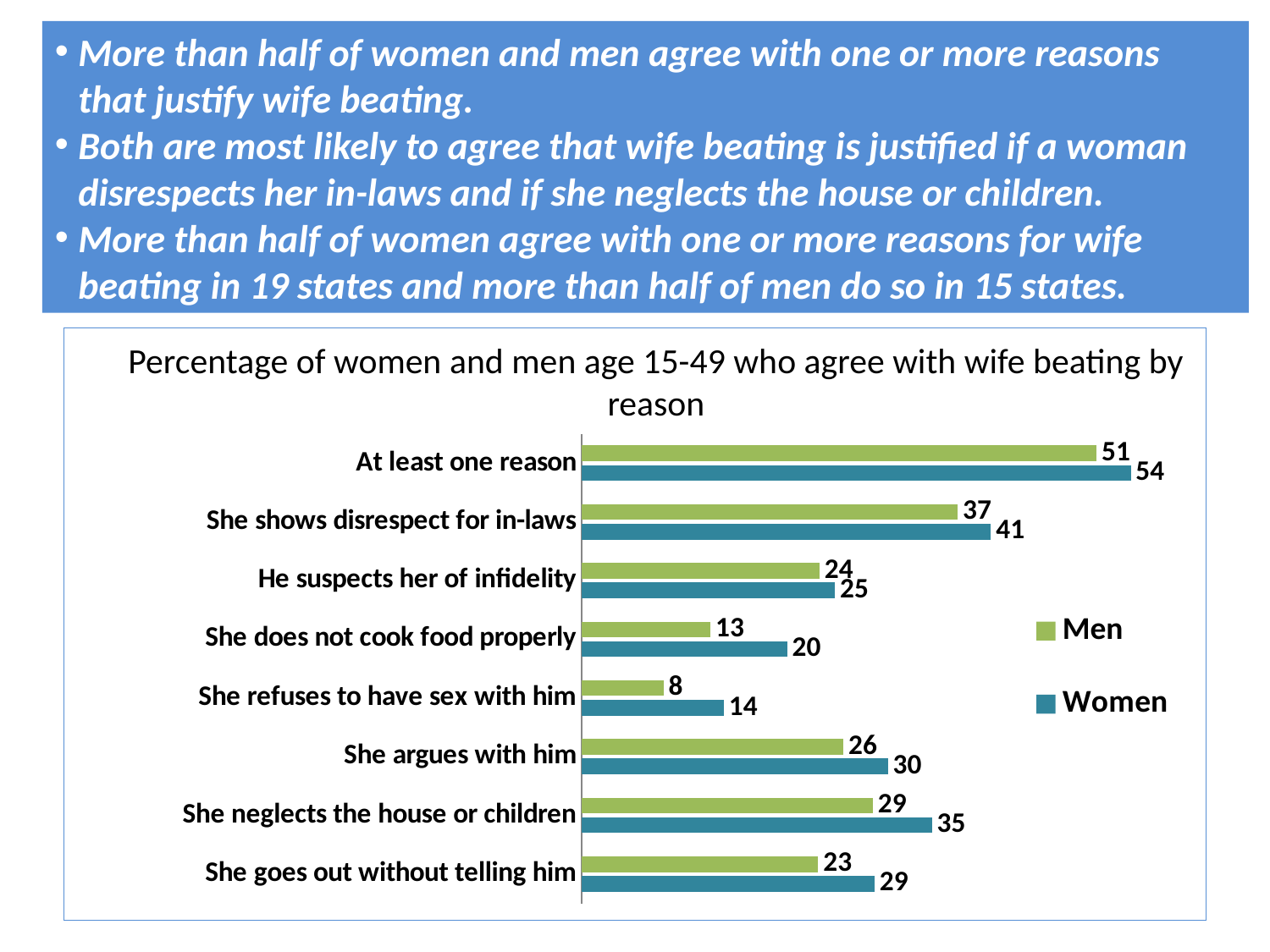
What is the difference between the women's and men's values for 'She does not cook food properly'? 7 How many reason categories are shown on the chart? 8 What is the difference between the women's and men's values for 'She neglects the house or children'? 6 Among the specific reasons (excluding 'At least one reason'), which reason has the highest value for women? She shows disrespect for in-laws What percentage of men agree that wife beating is justified if she does not cook food properly? 13 Which colour represents Men in the chart? Green For 'She argues with him', which is larger: the value for men or the value for women? Women What kind of chart is shown on the slide? Bar chart What is the value for women for 'She refuses to have sex with him'? 14 What percentage of women agree with wife beating for at least one reason? 54 Which reason has the lowest value for men? She refuses to have sex with him How many series does the legend list? 2